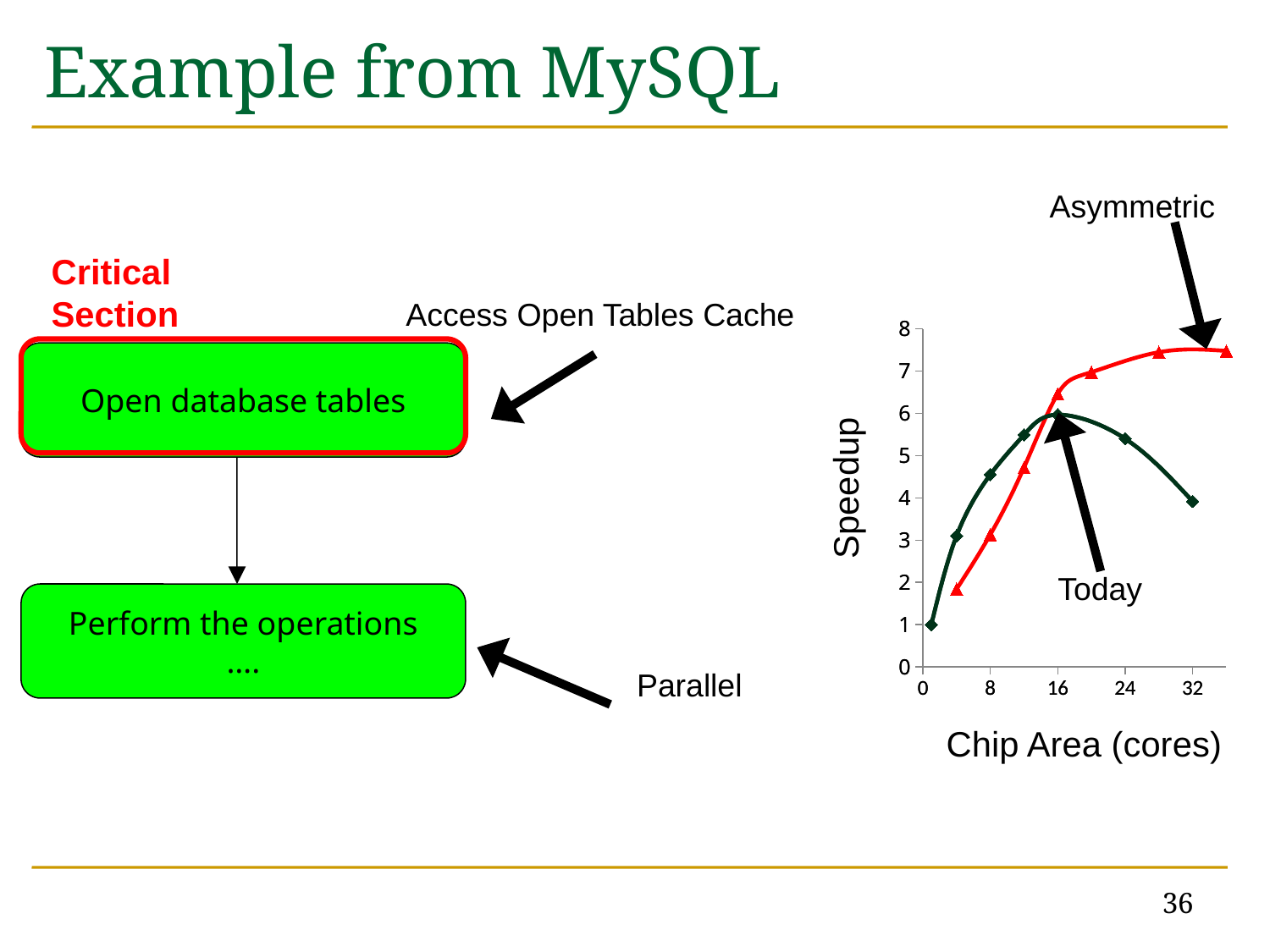
Which line reaches the highest speedup in the chart? Asymmetric At 32 cores, which line shows the higher speedup, Asymmetric or Today? Asymmetric What is the label of the y axis of the chart? Speedup How many lines are plotted in the Speedup chart? 2 At 8 cores, which line shows the higher speedup, Asymmetric or Today? Today What kind of chart is shown on the right of the slide? line chart What is the label of the x axis of the chart? Chip Area (cores) Is the speedup of the Today line at 32 cores greater or less than 5? less Does the Asymmetric line rise or fall as chip area increases? rises Is the speedup of the Asymmetric line at 8 cores greater or less than 4? less Is the speedup of the Asymmetric line at 32 cores greater or less than 7? greater